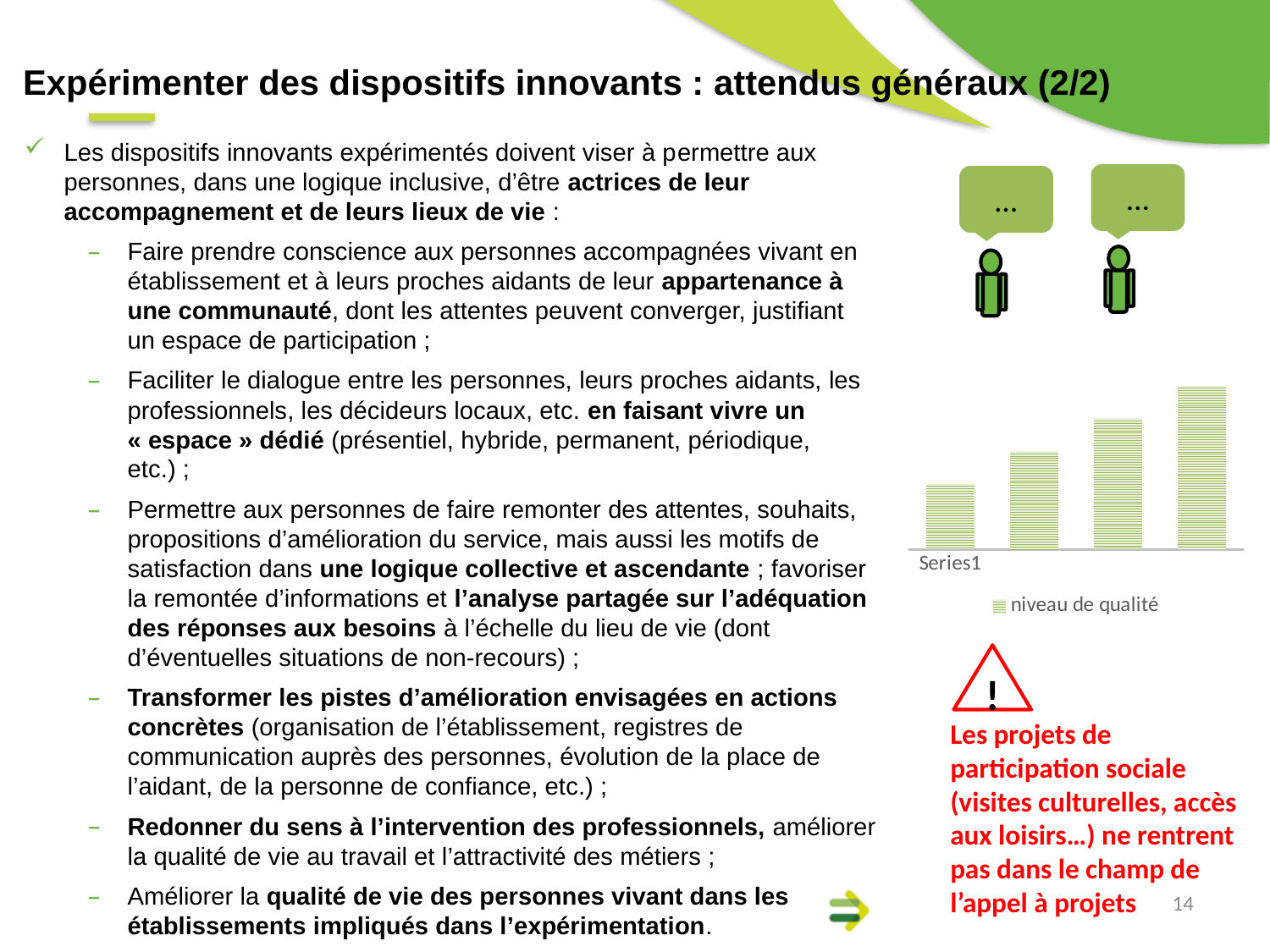
Do the bars in the chart rise or fall from left to right? rise What label appears below the horizontal axis of the chart? Series1 What is the series name shown in the chart's legend? niveau de qualité What kind of chart is shown on the right side of the slide? bar chart In the chart, is the second bar from the left taller or shorter than the third bar from the left? shorter Which bar in the chart is the tallest, the leftmost or the rightmost? the rightmost How many series does the legend of the chart list? 1 How many bars does the chart on the right side of the slide contain? 4 Which bar in the chart is the shortest, the leftmost or the rightmost? the leftmost